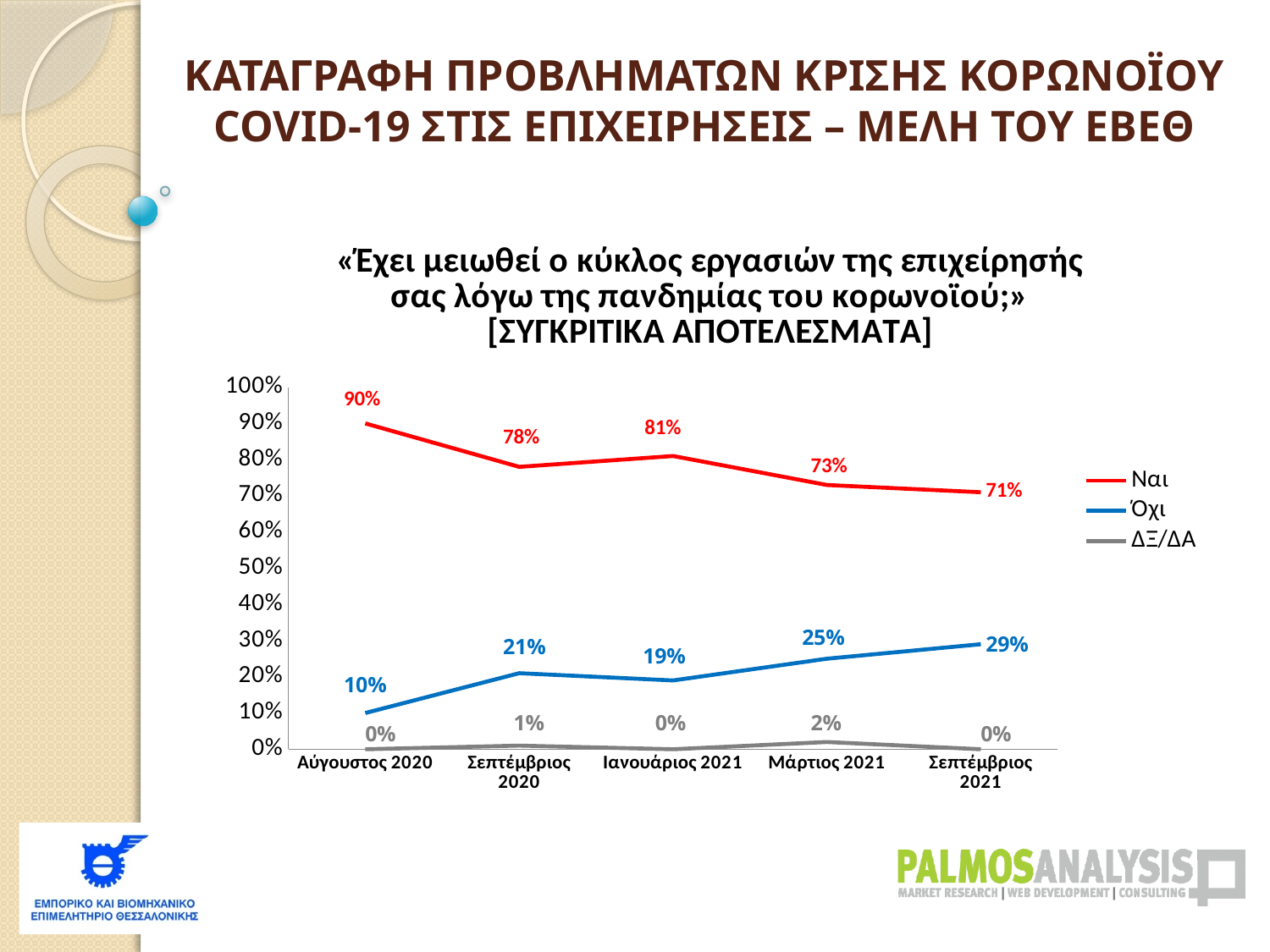
What is the value for ΔΞ/ΔΑ in Μάρτιος 2021? 2% Which is larger: the Όχι value in Σεπτέμβριος 2020 or in Ιανουάριος 2021? Σεπτέμβριος 2020 In which period is the Ναι series highest? Αύγουστος 2020 In which period is the Όχι series lowest? Αύγουστος 2020 What is the value for Ναι in Αύγουστος 2020? 90% Does the Όχι series generally rise or fall from Αύγουστος 2020 to Σεπτέμβριος 2021? rise What is the value for Όχι in Σεπτέμβριος 2021? 29% What kind of chart is shown? line chart Is the Ναι value for Μάρτιος 2021 greater or less than 80%? less How many time periods are shown on the x axis? 5 What is the difference between the Ναι values in Αύγουστος 2020 and Σεπτέμβριος 2021? 19% How many series does the legend list? 3